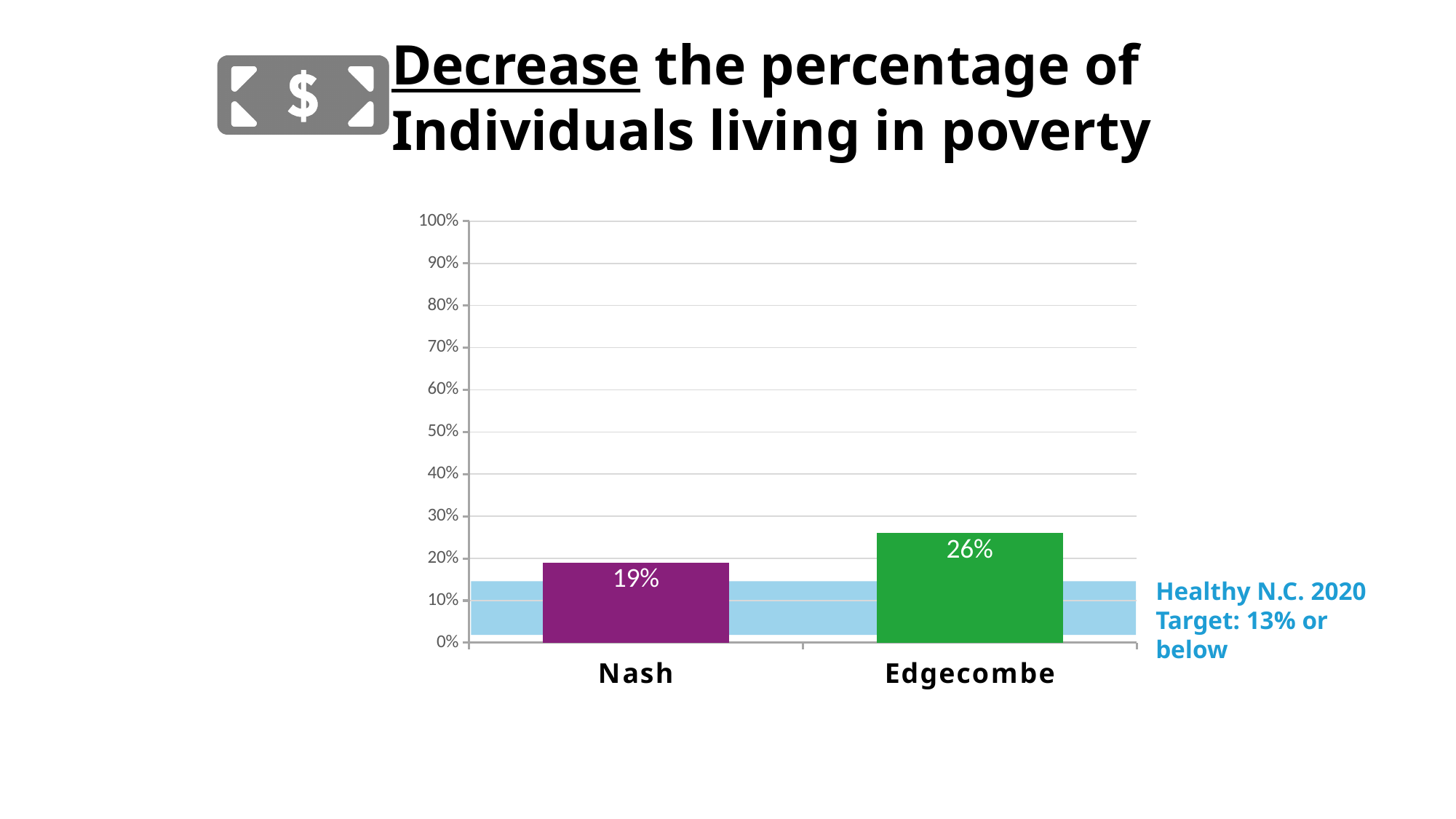
Is the value for Nash greater or less than 10%? greater Which county has the lower percentage of individuals living in poverty? Nash Is the value for Nash larger or smaller than the value for Edgecombe? smaller What is the Healthy N.C. 2020 target shown on the slide? 13% or below How many counties are shown on the chart? 2 Which county has the higher percentage of individuals living in poverty? Edgecombe What is the percentage of individuals living in poverty for Edgecombe? 26% What colour is the bar for Edgecombe? green Is the value for Edgecombe greater or less than 30%? less What is the percentage of individuals living in poverty for Nash? 19% What is the difference in percentage points between Edgecombe and Nash? 7% What kind of chart is shown on the slide? bar chart